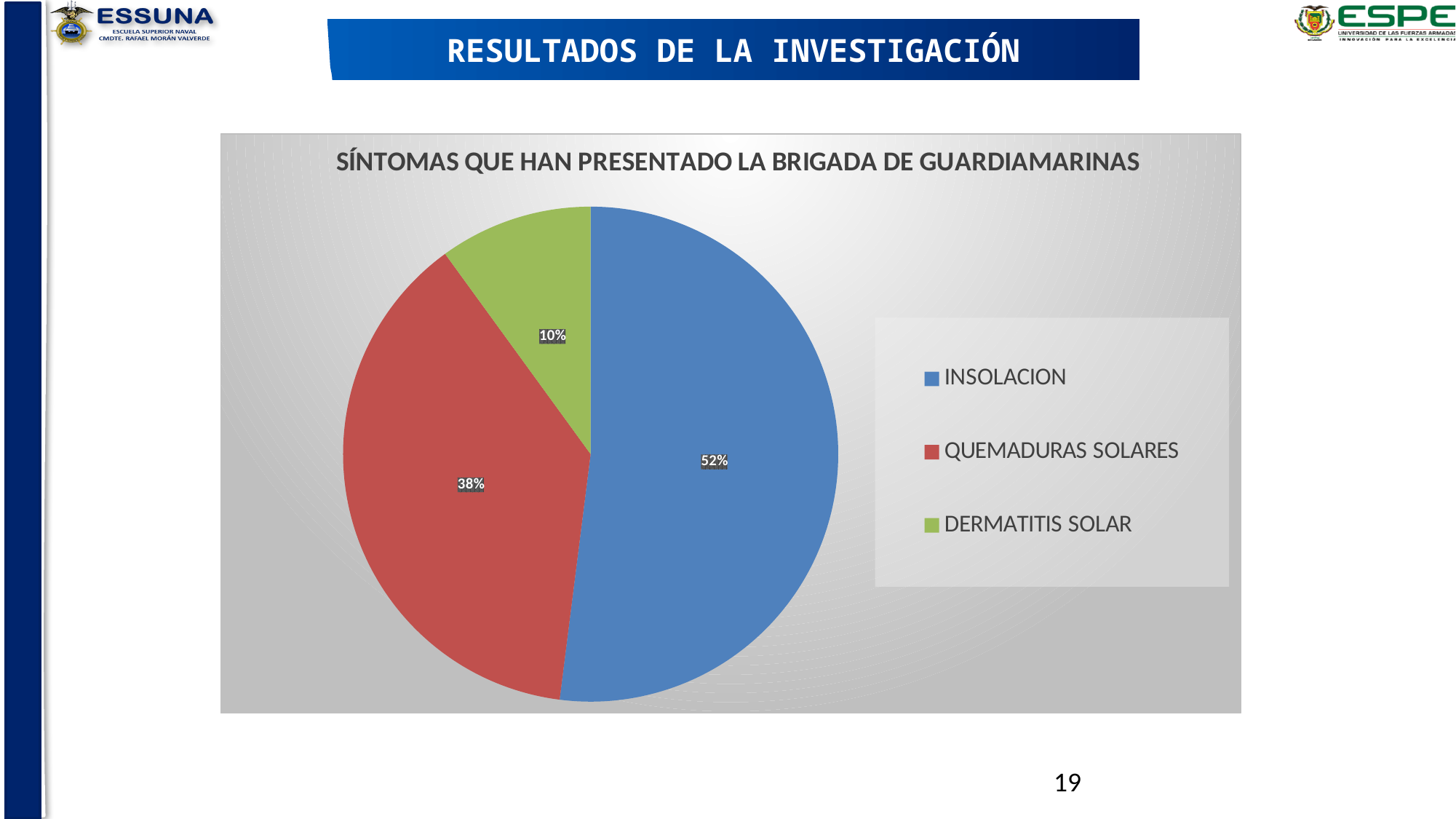
How many categories are shown in the pie chart? 3 What is the title of the chart? SÍNTOMAS QUE HAN PRESENTADO LA BRIGADA DE GUARDIAMARINAS What colour is the slice for INSOLACION? Blue What is the difference in percentage points between INSOLACION and QUEMADURAS SOLARES? 14 What share of the pie does QUEMADURAS SOLARES represent? 38% What share of the pie does INSOLACION represent? 52% Which category has the largest slice of the pie? INSOLACION What kind of chart is shown on the slide? Pie chart What is the difference in percentage points between QUEMADURAS SOLARES and DERMATITIS SOLAR? 28 What share of the pie does DERMATITIS SOLAR represent? 10% Which category has the smallest slice of the pie? DERMATITIS SOLAR Which is larger, the slice for QUEMADURAS SOLARES or the slice for DERMATITIS SOLAR? QUEMADURAS SOLARES